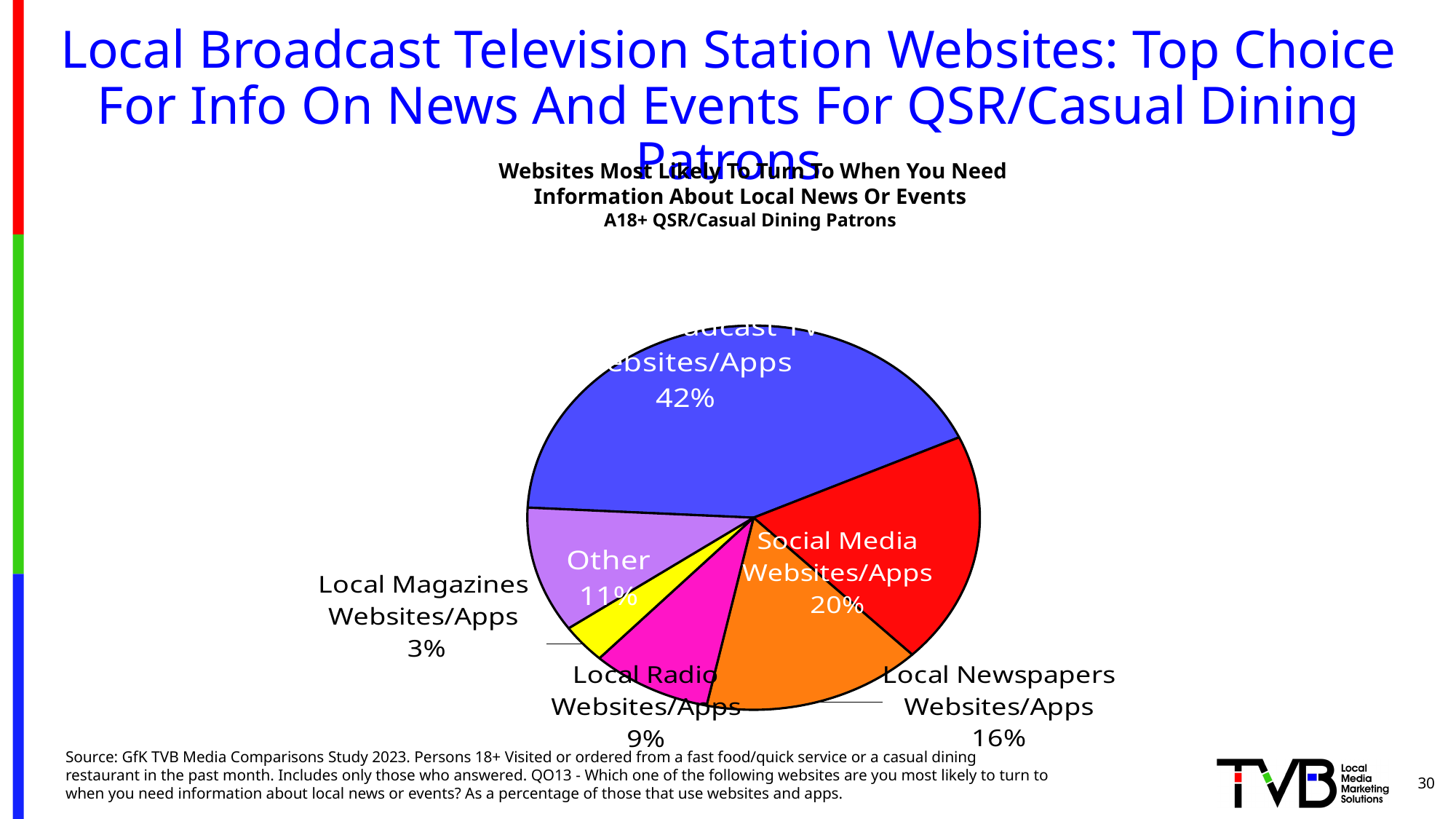
What percentage of the pie is Social Media Websites/Apps? 20% Which category has the smallest share of the pie? Local Magazines Websites/Apps What percentage of the pie is Local Radio Websites/Apps? 9% How many slices does the pie chart have? 6 What percentage of the pie is Local Magazines Websites/Apps? 3% Which category has the largest share of the pie? Local Broadcast TV Websites/Apps What percentage is shown for the largest (blue) slice, Local Broadcast TV Websites/Apps? 42% What is the difference in percentage points between Social Media Websites/Apps and Local Newspapers Websites/Apps? 4 What percentage of the pie is Local Newspapers Websites/Apps? 16% Which is larger: Local Radio Websites/Apps or Other? Other What percentage of the pie is the Other slice? 11% What kind of chart is shown on the slide? pie chart